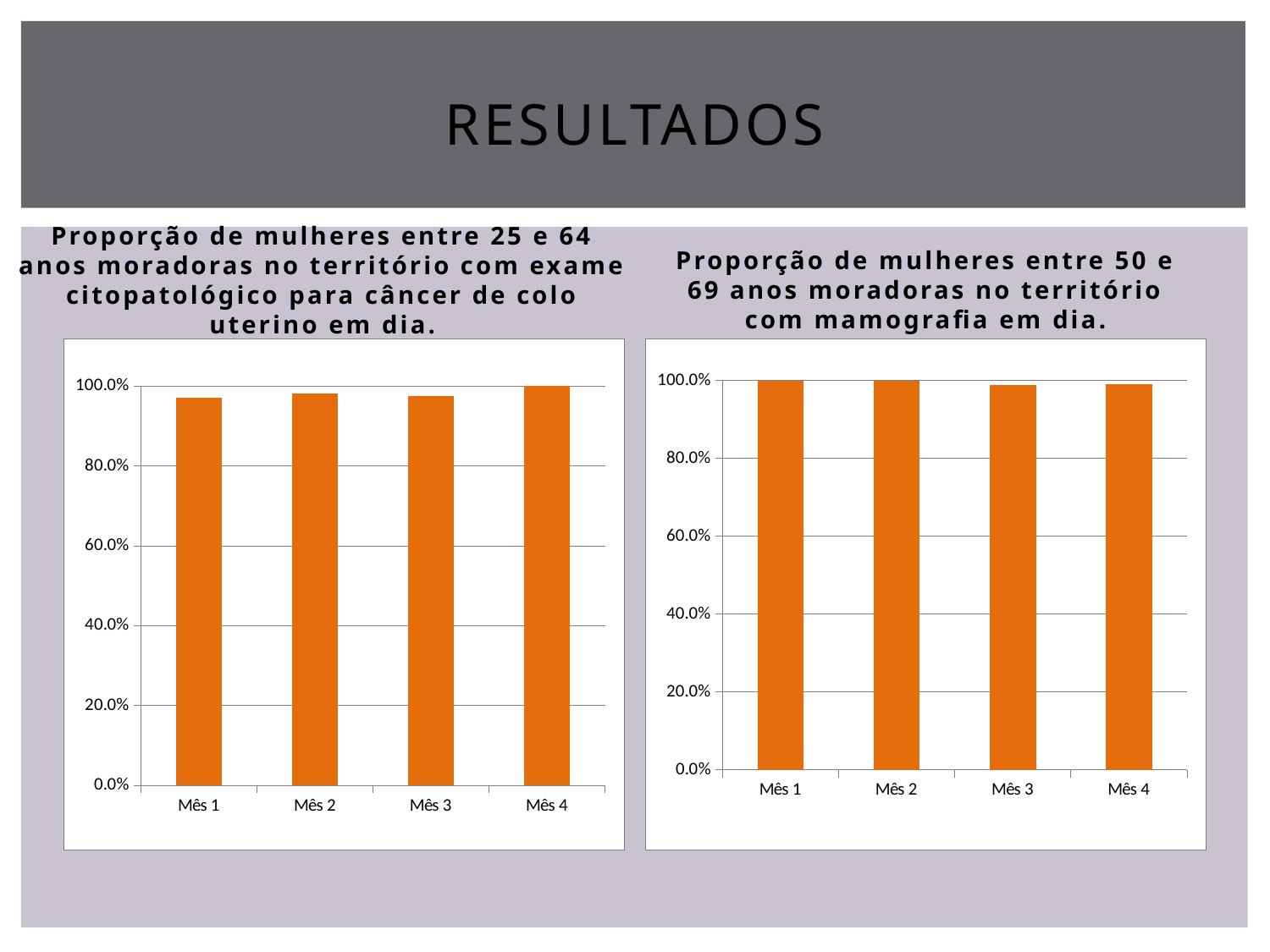
In the left chart (exame citopatológico), which month has the highest bar? Mês 4 In the left chart (exame citopatológico), how many categories are shown on the x axis? 4 In the right chart (mamografia), how many bars are plotted? 4 In the left chart (exame citopatológico), is the value for Mês 1 greater or less than 80.0%? greater In the right chart (mamografia), is the value for Mês 2 greater or less than 40.0%? greater In the left chart (exame citopatológico), what is the label of the first category on the x axis? Mês 1 In the right chart (mamografia), is the value for Mês 4 greater or less than 80.0%? greater What kind of chart is the right chart, titled 'Proporção de mulheres entre 50 e 69 anos moradoras no território com mamografia em dia.'? bar chart What colour are the bars in the right chart (mamografia)? orange What kind of chart is the left chart, titled 'Proporção de mulheres entre 25 e 64 anos moradoras no território com exame citopatológico para câncer de colo uterino em dia.'? bar chart In the right chart (mamografia), what is the highest tick value shown on the y axis? 100.0%